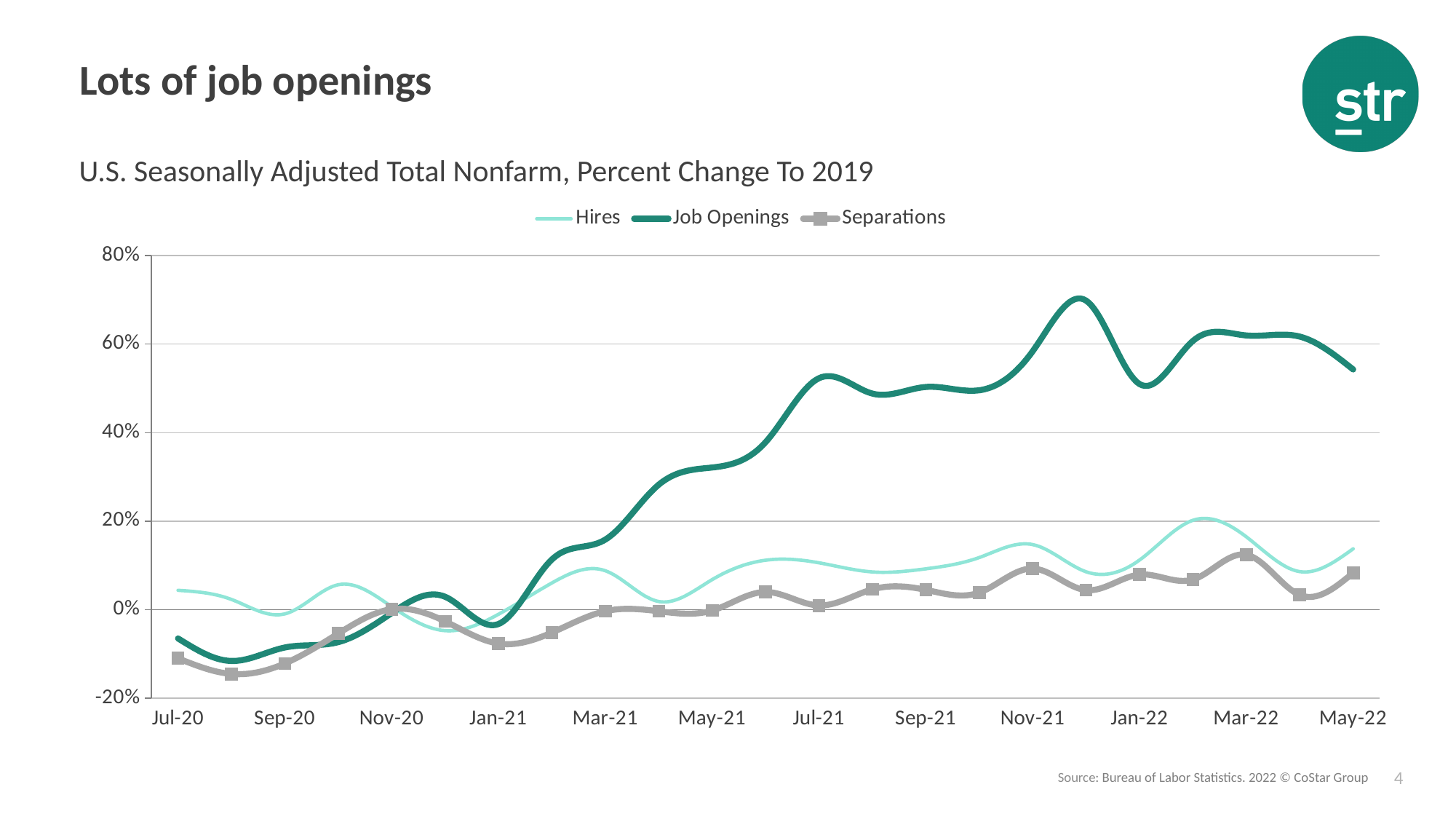
Is the value for Job Openings at May-22 greater or less than 60%? less What is the subtitle describing the chart's data? U.S. Seasonally Adjusted Total Nonfarm, Percent Change To 2019 Which series reaches the highest value on the chart? Job Openings Is the value for Separations at Jul-20 greater or less than 0%? less Is the value for Hires at Nov-21 greater or less than 20%? less At May-22, which is larger: Job Openings or Hires? Job Openings At Jul-20, which is larger: Hires or Separations? Hires What kind of chart is shown on the slide? Line chart How many series does the legend list? 3 Does the Job Openings line rise or fall between Jan-21 and Jul-21? Rise Which series has the lowest value at Jul-20? Separations